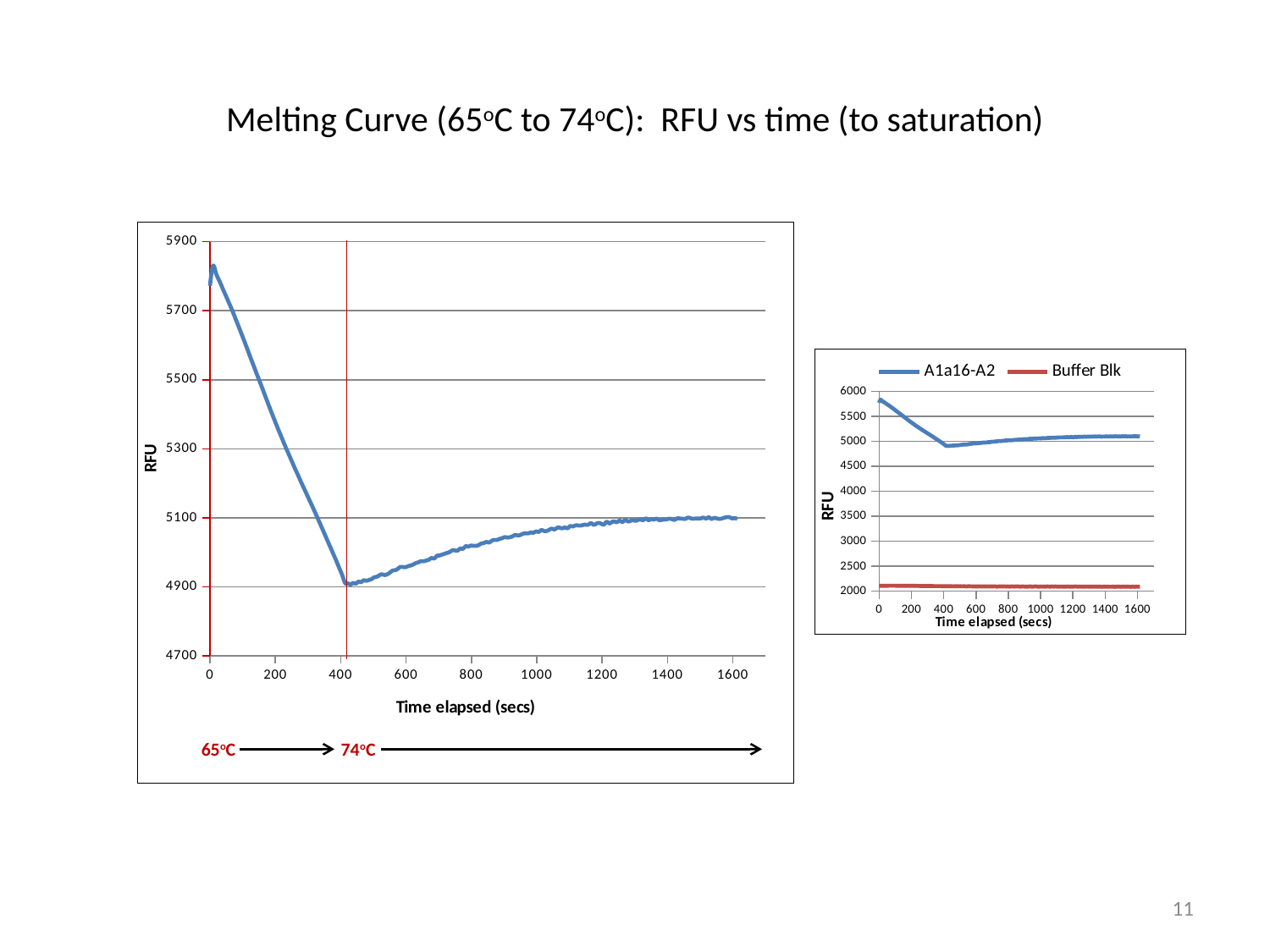
In the large chart on the left, is the RFU value at 0 seconds greater or less than 5700? greater In the large chart on the left, does the RFU value rise or fall between 400 and 1600 seconds? rise In the smaller chart on the right, which series has the higher RFU values, A1a16-A2 or Buffer Blk? A1a16-A2 In the smaller chart on the right, is the A1a16-A2 value at 0 seconds greater or less than 5500? greater What kind of chart is the large chart on the left of the slide? line chart What are the two series named in the legend of the smaller chart on the right? A1a16-A2 and Buffer Blk In the large chart on the left, is the RFU value at 1600 seconds greater or less than 5300? less What is the x-axis label of the large chart on the left? Time elapsed (secs) How many series does the legend of the smaller chart on the right list? 2 In the large chart on the left, does the RFU value rise or fall between 0 and 400 seconds? fall